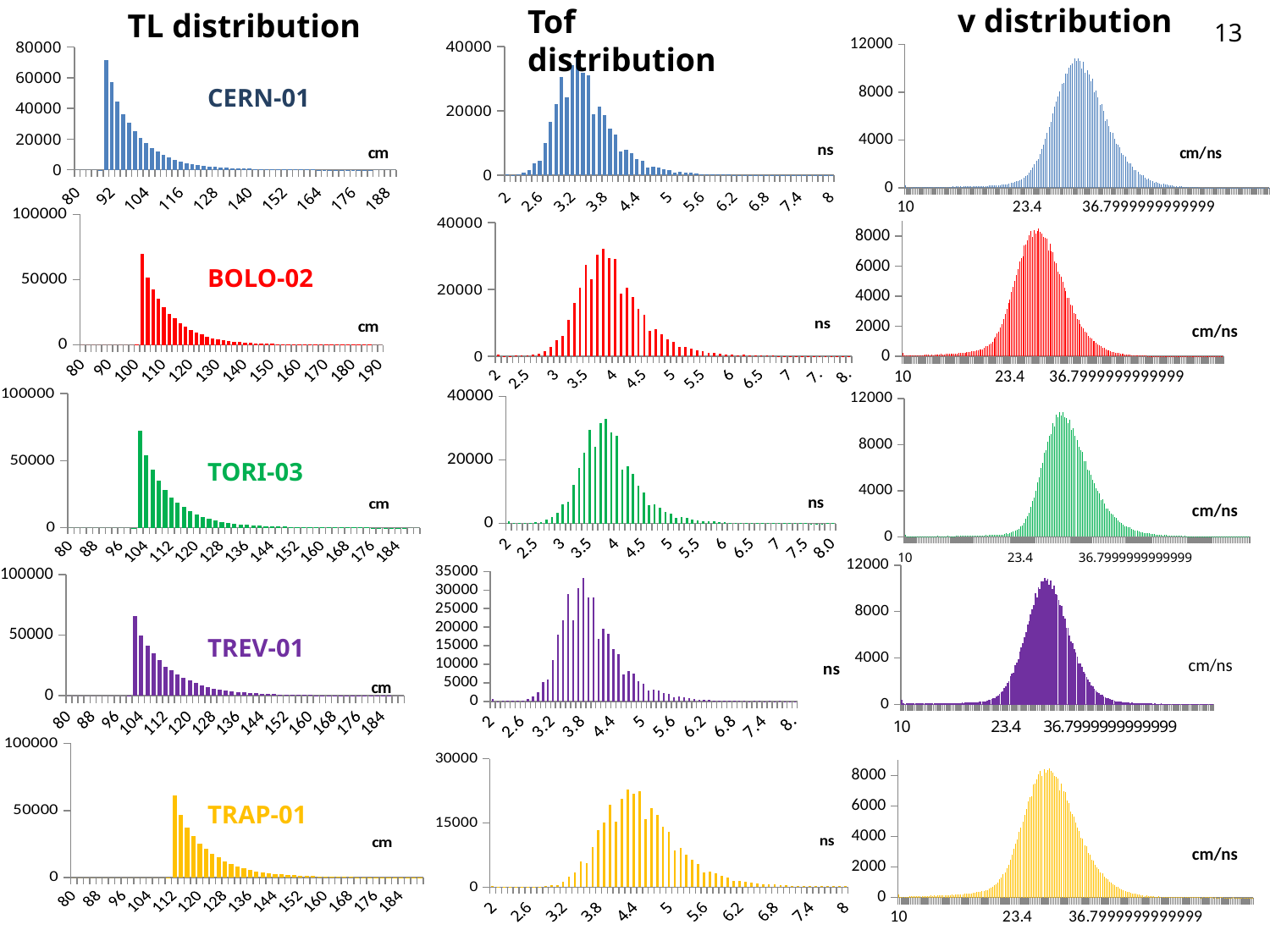
In the TL distribution chart for CERN-01, is the tallest bar greater or less than 60000? greater In the TL distribution chart for TRAP-01, is the tallest bar greater or less than 100000? less In the v distribution chart for BOLO-02, is the tallest bar greater or less than 6000? greater What colour are the bars in the charts for TREV-01? purple In the TL distribution chart for TORI-03, do the bar heights rise or fall from 104 cm to 184 cm? fall What unit is shown on the x axis of the v distribution charts? cm/ns What kind of chart is the TL distribution for CERN-01? bar chart